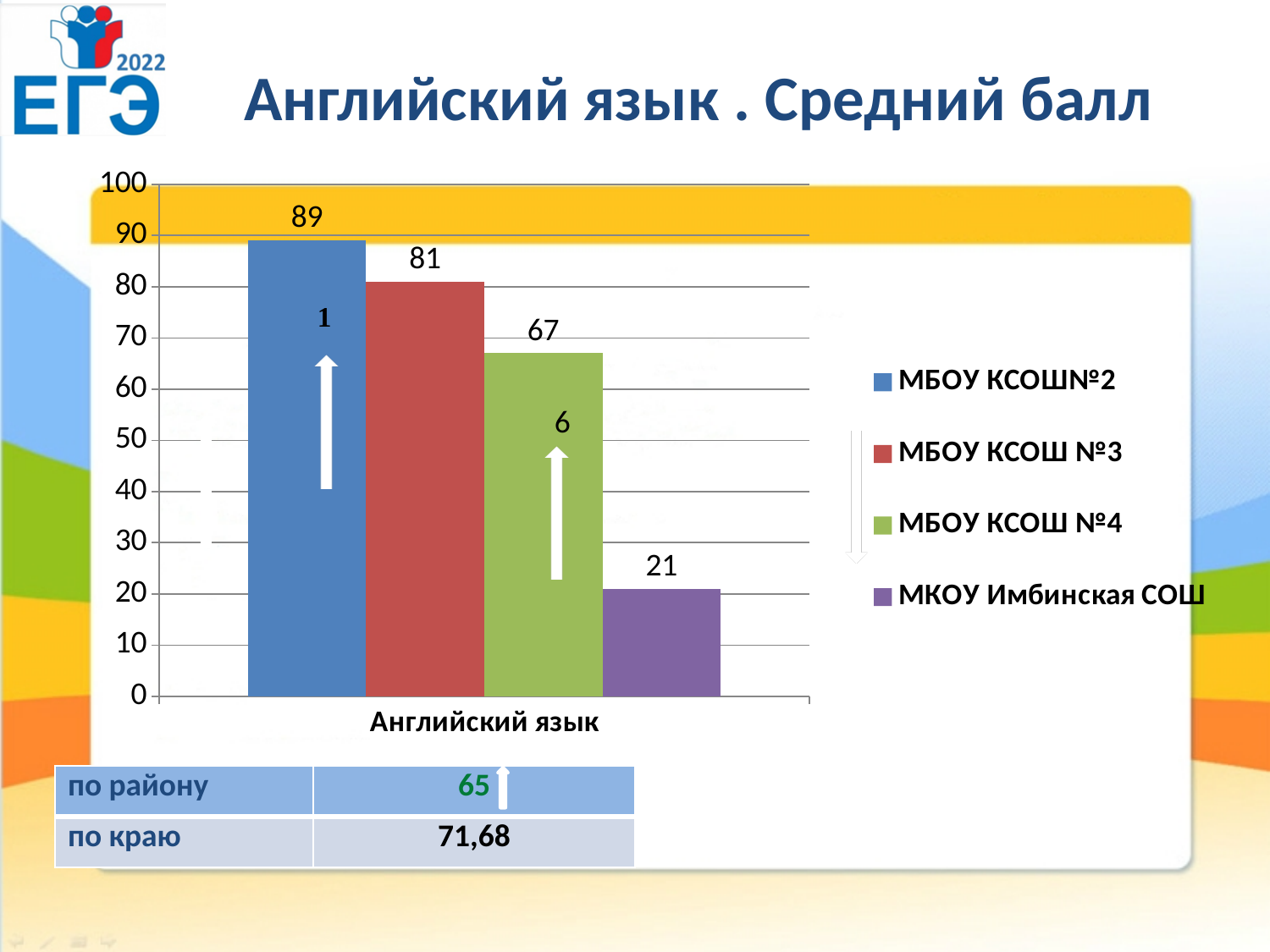
What is the average score for МБОУ КСОШ №3? 81 What kind of chart is shown on the slide? bar chart What is the difference between the average scores of МБОУ КСОШ №4 and МКОУ Имбинская СОШ? 46 How many series does the legend list? 4 Which school has the highest average score? МБОУ КСОШ№2 What is the average score for МБОУ КСОШ№2? 89 What is the difference between the average scores of МБОУ КСОШ№2 and МБОУ КСОШ №3? 8 What is the average score for МБОУ КСОШ №4? 67 What is the average score for МКОУ Имбинская СОШ? 21 Which has a higher average score, МБОУ КСОШ №3 or МБОУ КСОШ №4? МБОУ КСОШ №3 What is the title of the slide's chart? Английский язык . Средний балл Which school has the lowest average score? МКОУ Имбинская СОШ